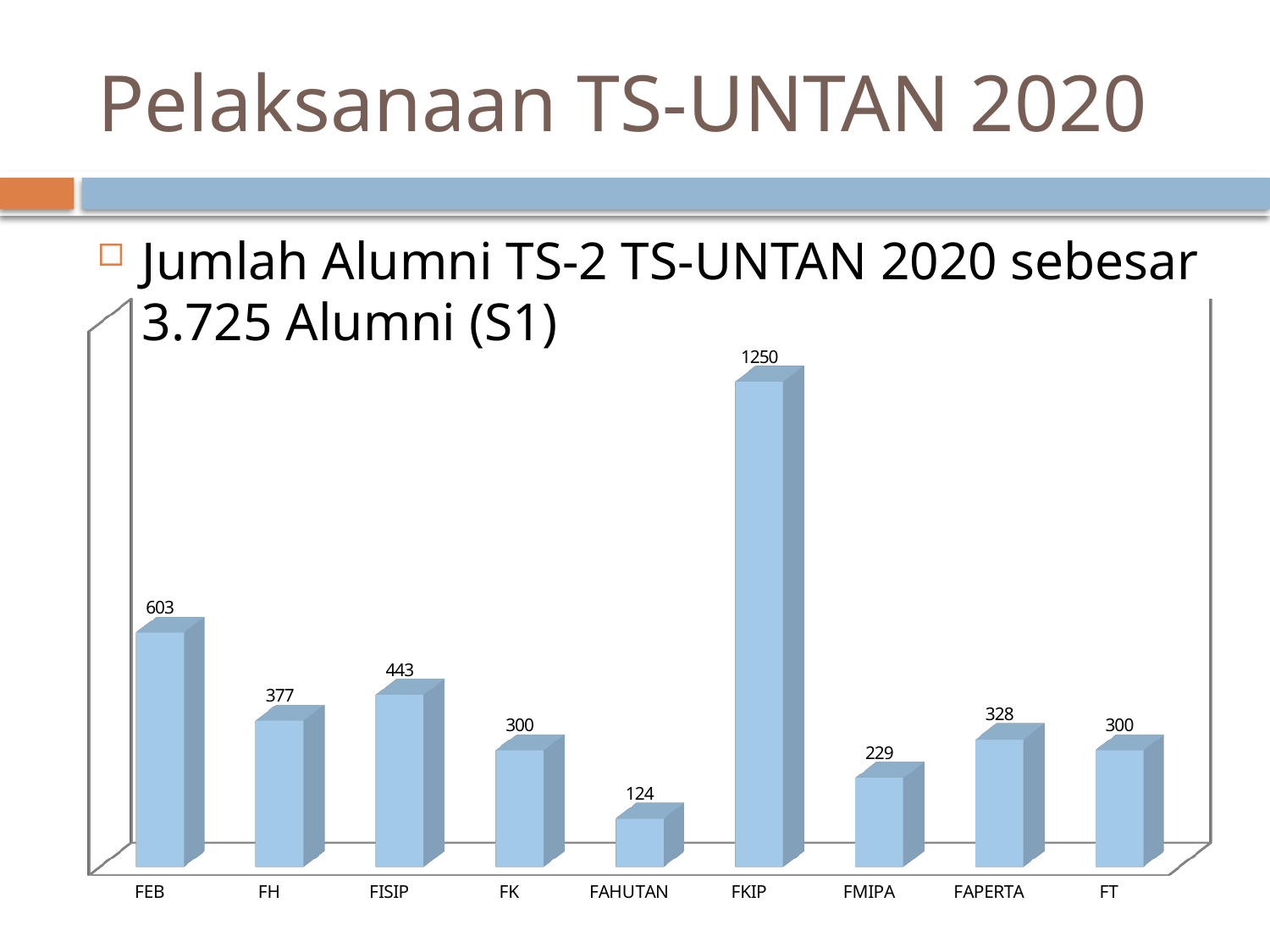
What kind of chart is shown on the slide? bar chart What is the value for FAPERTA? 328 How many categories are shown on the x axis? 9 What is the difference between the values for FKIP and FEB? 647 What is the difference between the values for FISIP and FH? 66 Which category has the highest value? FKIP What is the value for FEB? 603 What is the value for FKIP? 1250 Which is larger, the value for FMIPA or the value for FAPERTA? FAPERTA Which two categories share the same value of 300? FK and FT Which category has the lowest value? FAHUTAN What is the value for FAHUTAN? 124